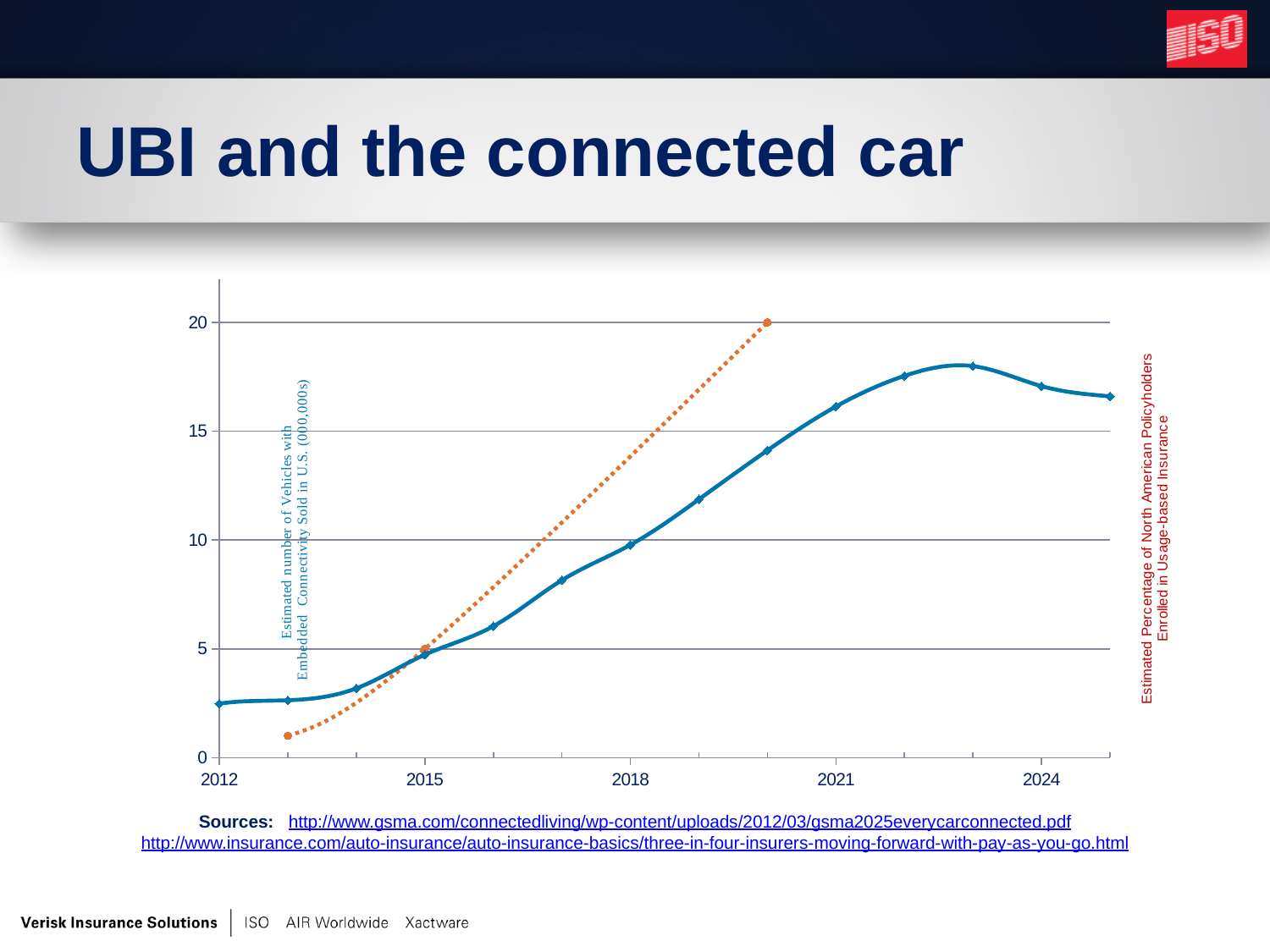
What is the first year shown on the x axis of the chart? 2012 What is the highest value labelled on the y axis of the chart? 20 In 2018, which line has the higher value: the blue solid line or the orange dotted line? the orange dotted line What type of chart is shown on the slide? line chart How many data series are plotted on the chart? 2